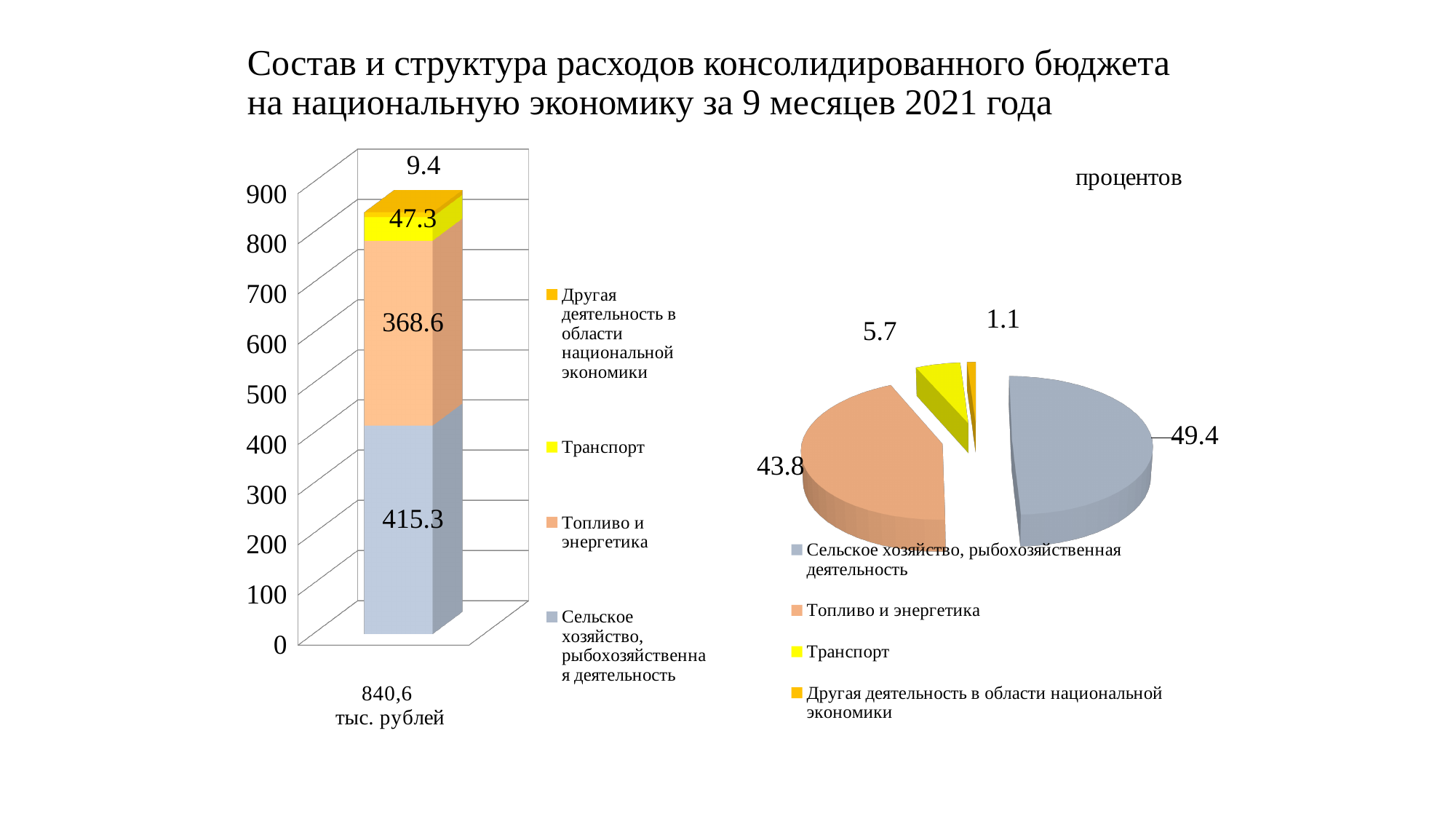
In the bar chart on the left, what is the value for Транспорт? 47.3 In the pie chart on the right, which is larger: the slice for Транспорт or the slice for Другая деятельность в области национальной экономики? Транспорт In the pie chart on the right, which slice is the largest? Сельское хозяйство, рыбохозяйственная деятельность In the bar chart on the left, what is the difference between the values for Сельское хозяйство, рыбохозяйственная деятельность and Топливо и энергетика? 46.7 What kind of chart is on the right side of the slide? pie chart In the pie chart on the right, what is the share for Транспорт? 5.7 In the bar chart on the left, which segment has the smallest value? Другая деятельность в области национальной экономики In the bar chart on the left, what is the value for Сельское хозяйство, рыбохозяйственная деятельность? 415.3 What kind of chart is on the left side of the slide? bar chart In the bar chart on the left, what is the value for Топливо и энергетика? 368.6 In the bar chart on the left, how many series does the legend list? 4 In the pie chart on the right, what is the share for Сельское хозяйство, рыбохозяйственная деятельность? 49.4